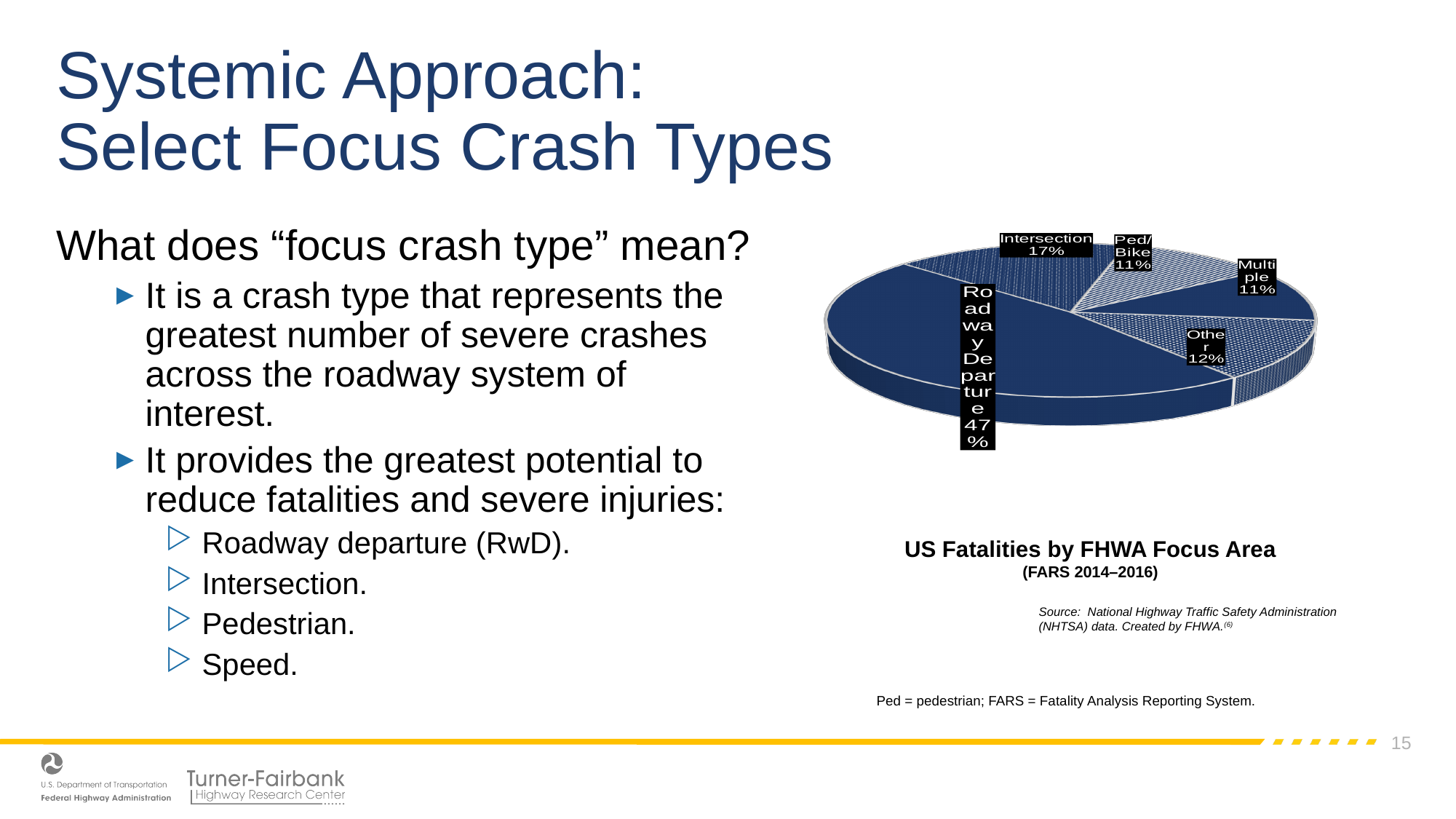
What share of US fatalities is attributed to Multiple? 11% What is the title of the chart? US Fatalities by FHWA Focus Area (FARS 2014–2016) What share of US fatalities is attributed to Other? 12% What share of US fatalities is attributed to Intersection? 17% What share of US fatalities is attributed to Ped/Bike? 11% Which has a larger share of US fatalities, Intersection or Other? Intersection What is the combined share of the Ped/Bike and Multiple slices? 22% Which focus area has the largest share of US fatalities? Roadway Departure How many slices does the pie chart have? 5 What type of chart is shown on the slide? Pie chart What share of US fatalities is attributed to Roadway Departure? 47% What is the difference in percentage points between the Roadway Departure and Intersection shares? 30 percentage points